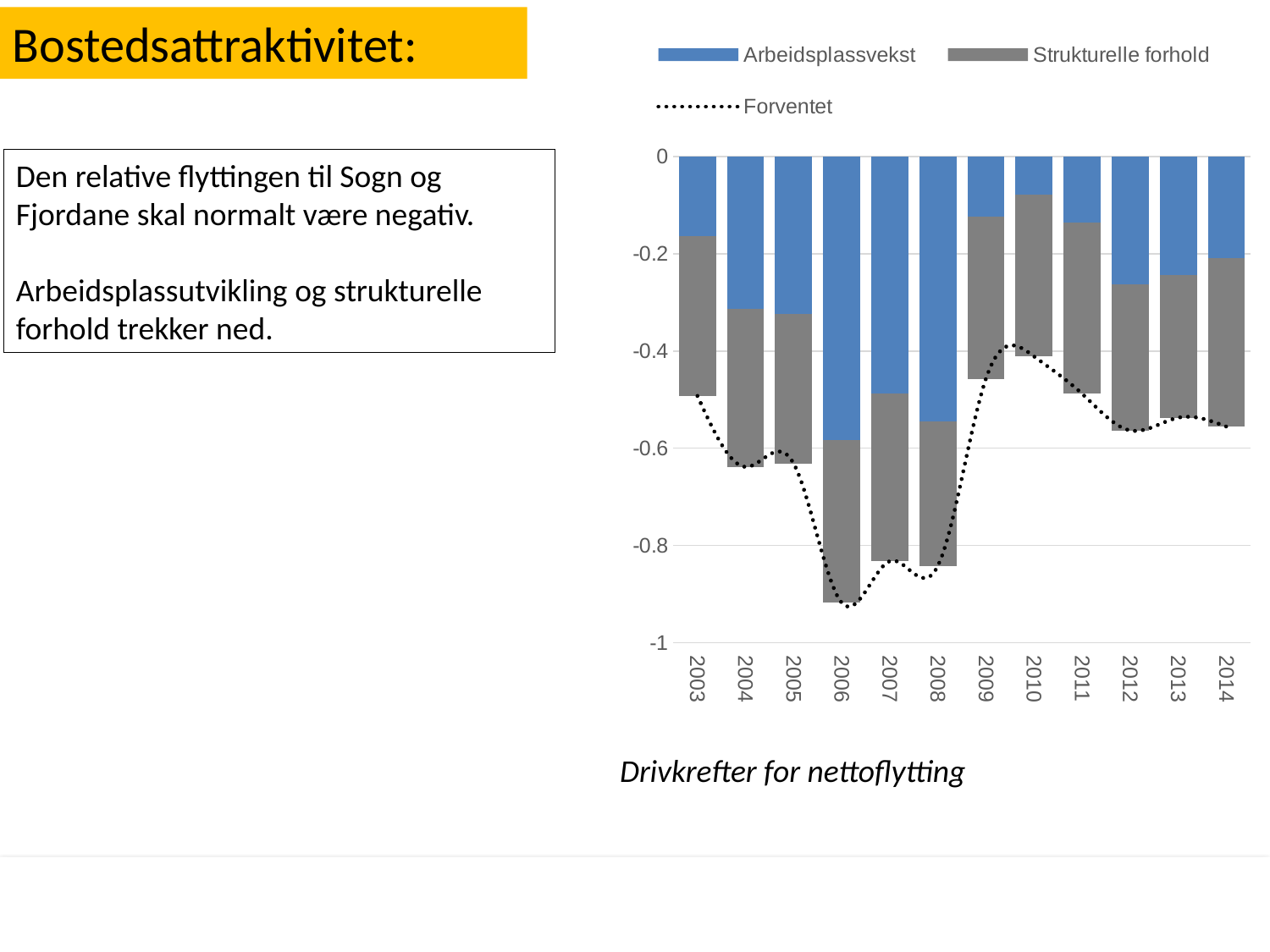
Which year has the most negative (longest) stacked bar? 2006 Is the Arbeidsplassvekst value for 2006 greater or less than -0.4? less From 2006 to 2010, do the stacked bar totals move toward zero or further from zero? Toward zero Which year has the stacked bar closest to zero (shortest)? 2010 How many years are shown on the x axis of the chart? 12 Is the total stacked value for 2012 greater or less than -0.6? greater Which year has the more negative total stacked bar, 2003 or 2006? 2006 Is the total stacked value for 2003 greater or less than -0.6? greater How many series does the chart's legend list? 3 What kind of chart is shown on the slide? Stacked bar chart with a dotted line What is the name of the series drawn as a dotted line? Forventet